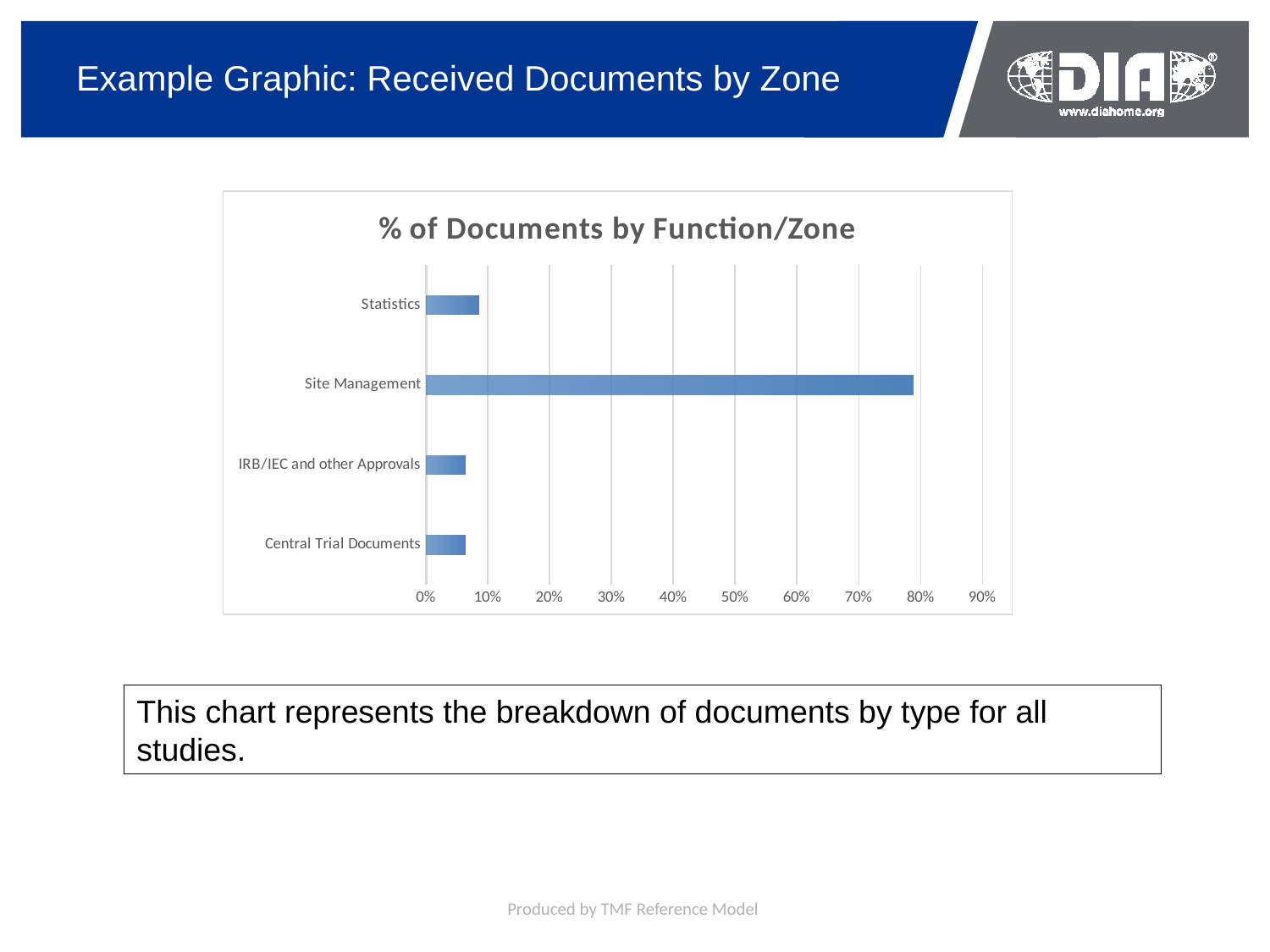
Which is larger, the value for Site Management or the value for Statistics? Site Management What is the highest tick label shown on the horizontal axis? 90% Is the value for Statistics greater or less than 20%? less Is the value for IRB/IEC and other Approvals greater or less than 10%? less What is the title of the chart? % of Documents by Function/Zone Is the value for Central Trial Documents greater or less than 10%? less What kind of chart is shown on the slide? bar chart How many categories are plotted in the chart? 4 Which is larger, the value for Site Management or the value for Central Trial Documents? Site Management Which category has the highest percentage of documents? Site Management